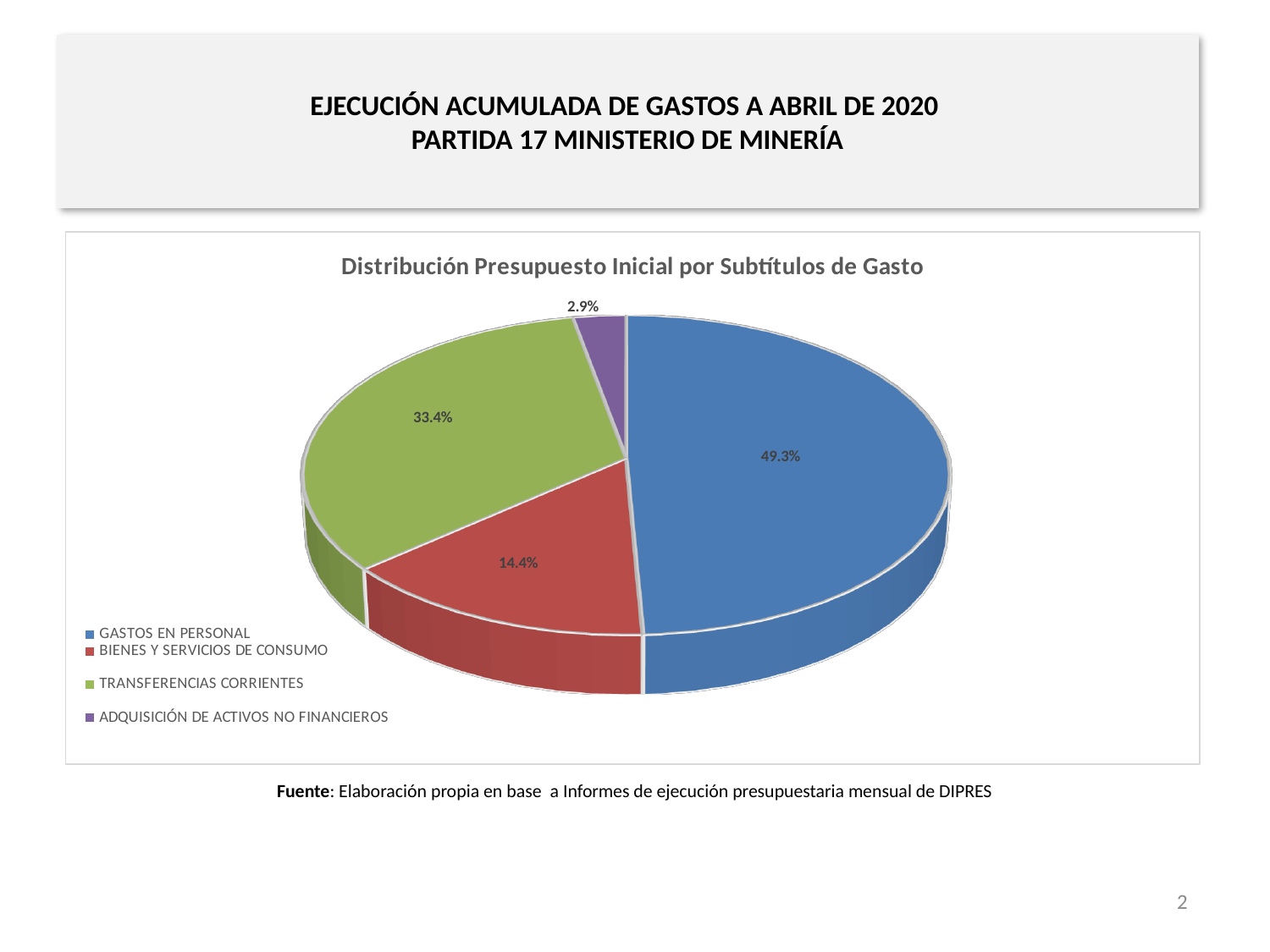
How many categories does the pie chart show? 4 What is the difference in percentage points between BIENES Y SERVICIOS DE CONSUMO and ADQUISICIÓN DE ACTIVOS NO FINANCIEROS? 11.5 What share of the pie does BIENES Y SERVICIOS DE CONSUMO represent? 14.4% What share of the pie does TRANSFERENCIAS CORRIENTES represent? 33.4% What share of the pie does GASTOS EN PERSONAL represent? 49.3% What is the difference in percentage points between GASTOS EN PERSONAL and TRANSFERENCIAS CORRIENTES? 15.9 What is the title of the chart? Distribución Presupuesto Inicial por Subtítulos de Gasto Which category has the smallest share of the pie? ADQUISICIÓN DE ACTIVOS NO FINANCIEROS Which is larger, the share for TRANSFERENCIAS CORRIENTES or the share for BIENES Y SERVICIOS DE CONSUMO? TRANSFERENCIAS CORRIENTES Which category has the largest share of the pie? GASTOS EN PERSONAL What kind of chart is shown on the slide? Pie chart